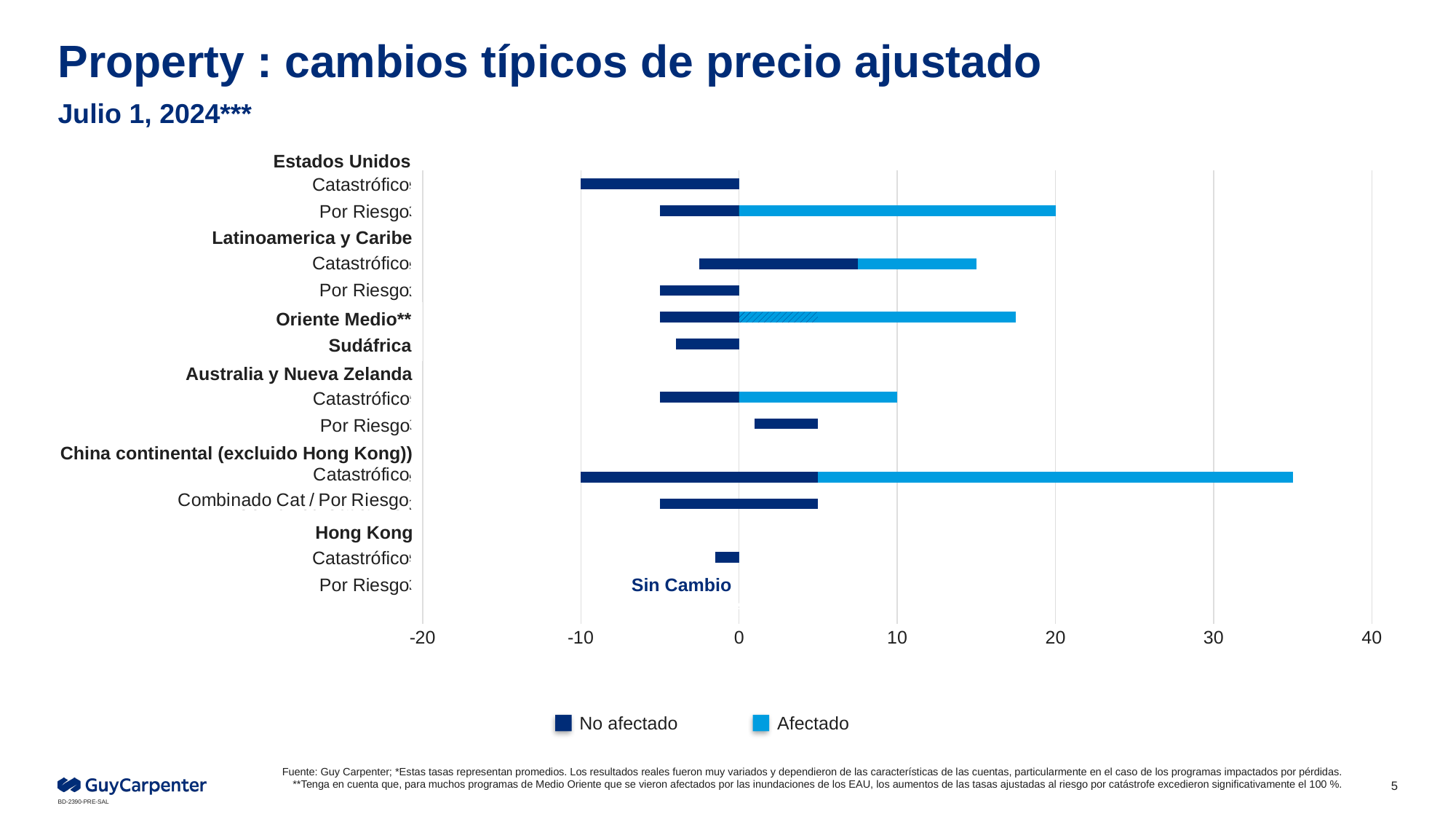
Which category's bar extends furthest to the right on the axis? China continental (excluido Hong Kong) Catastróficos What is the upper end of the Australia y Nueva Zelanda Catastróficos bar? 10 What are the two series named in the legend? No afectado and Afectado Which bar reaches further to the right: Latinoamerica y Caribe Catastróficos or Latinoamerica y Caribe Por Riesgo? Latinoamerica y Caribe Catastróficos Is the upper end of the China continental (excluido Hong Kong) Catastróficos bar greater or less than 30? greater What is the upper end of the Estados Unidos Por Riesgo bar? 20 How many series does the legend list? 2 Is the upper end of the Sudáfrica bar greater or less than 10? less What kind of chart is shown on the slide? Bar chart What is the lower end of the Estados Unidos Catastróficos bar? -10 Is the upper end of the Oriente Medio** bar greater or less than 10? greater What label is shown instead of a bar for Hong Kong Por Riesgo? Sin Cambio